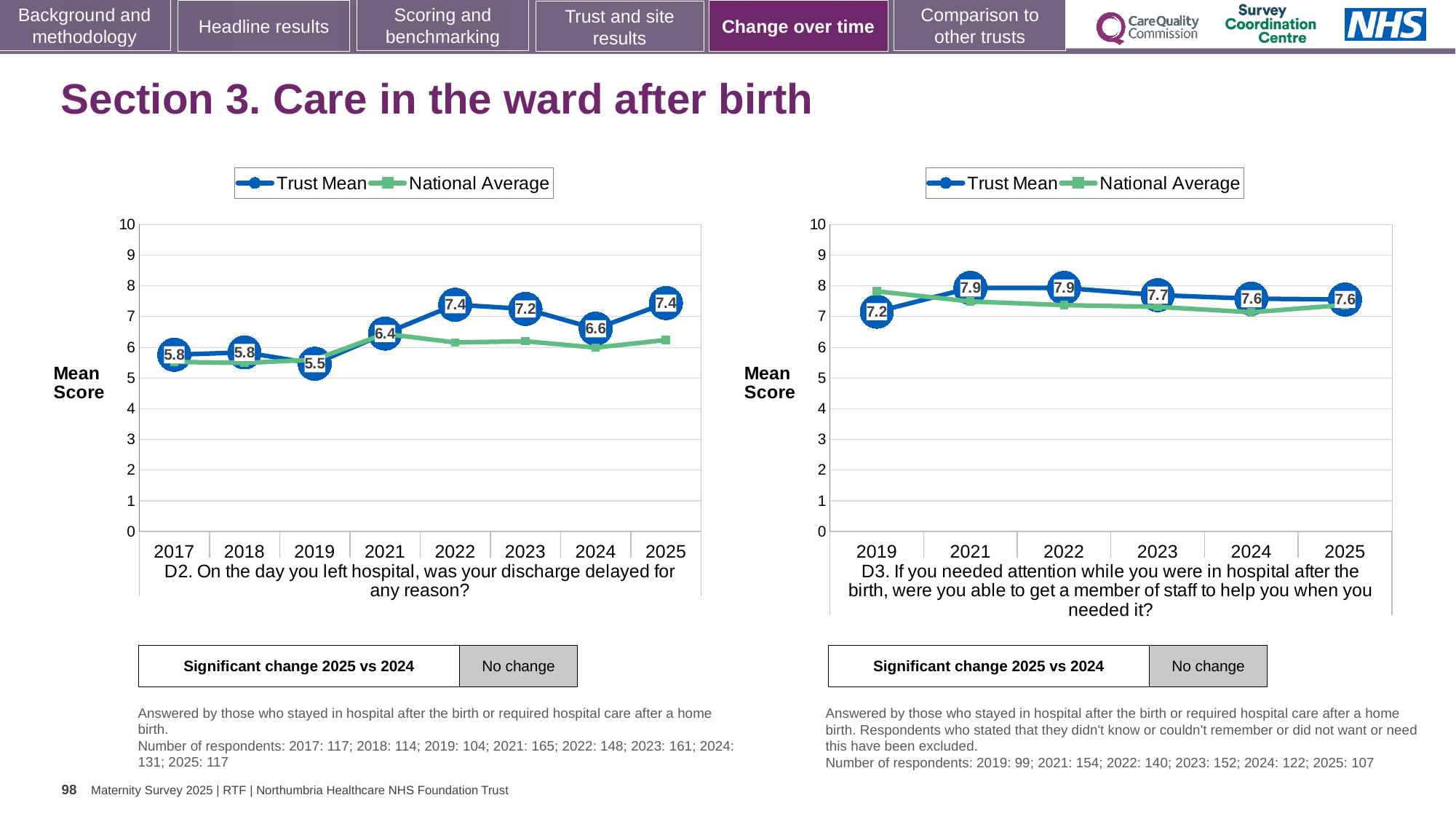
How many series does the legend of the D2 chart (left) list? 2 How many years are plotted on the x axis of the D3 chart (right)? 6 In the D2 chart (left), is the Trust Mean score for 2023 larger than the Trust Mean score for 2024? Yes In the D2 chart (left), which year has the lowest Trust Mean score? 2019 In the D3 chart (right), what is the difference between the Trust Mean scores for 2022 and 2019? 0.7 In the D2 chart (left), is the National Average value for 2025 greater or less than 7? less In the D2 chart (left), what is the difference between the Trust Mean scores for 2025 and 2024? 0.8 In the D3 chart (right), what is the Trust Mean score for 2025? 7.6 In the D2 chart (left), what is the Trust Mean score for 2022? 7.4 In the D3 chart (right), what is the Trust Mean score for 2021? 7.9 In the D3 chart (right), which year has the lowest Trust Mean score? 2019 In the D2 chart (left), what is the Trust Mean score for 2019? 5.5